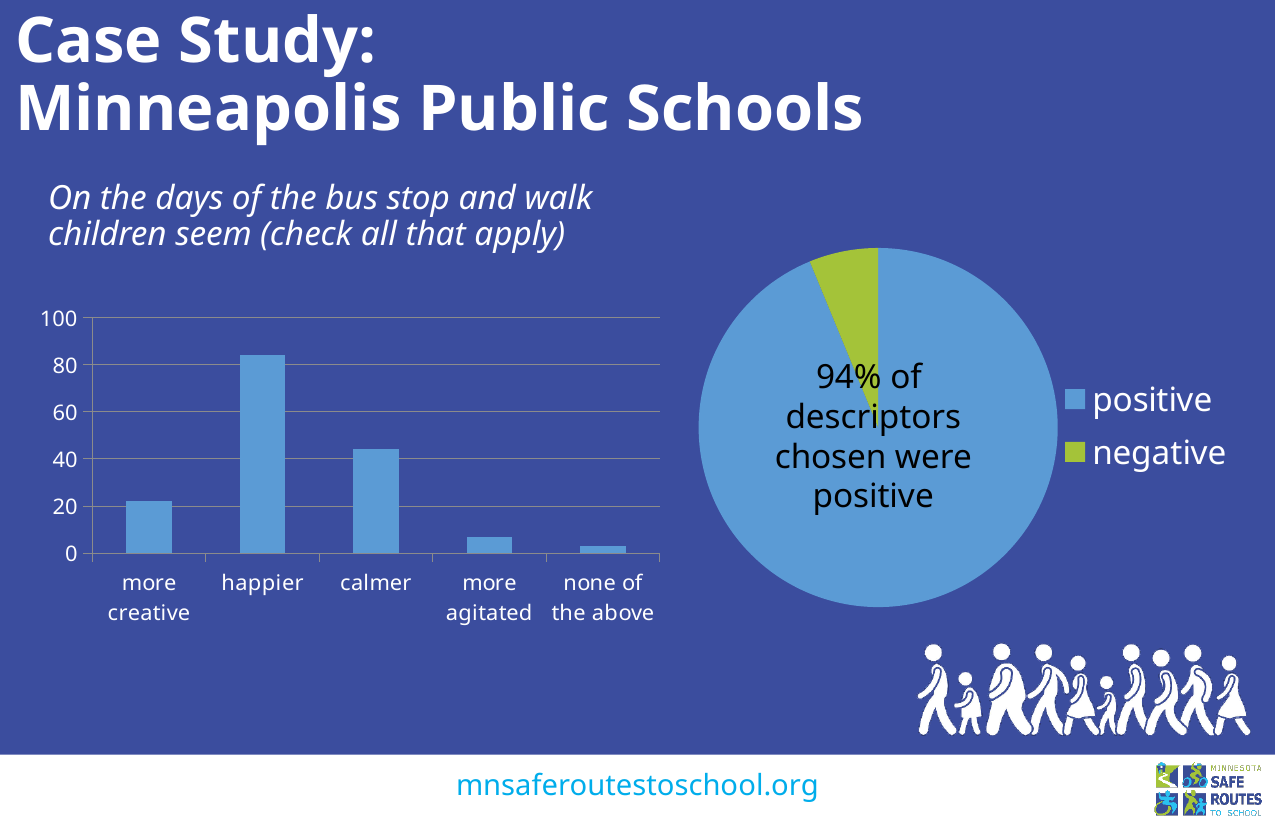
In the bar chart on the left, is the value for more creative greater or less than 40? less In the pie chart on the right, what share of descriptors chosen were positive? 94% In the bar chart on the left, which category has the highest value? happier How many entries does the legend of the pie chart on the right list? 2 In the bar chart on the left, how many categories are shown on the x axis? 5 In the pie chart on the right, which colour represents the negative slice? green In the bar chart on the left, which is larger, the value for calmer or the value for more creative? calmer In the bar chart on the left, is the value for happier greater or less than 80? greater In the bar chart on the left, is the value for calmer greater or less than 40? greater In the bar chart on the left, which category has the lowest value? none of the above What kind of chart is the chart on the left of the slide? bar chart What kind of chart is the chart on the right of the slide? pie chart